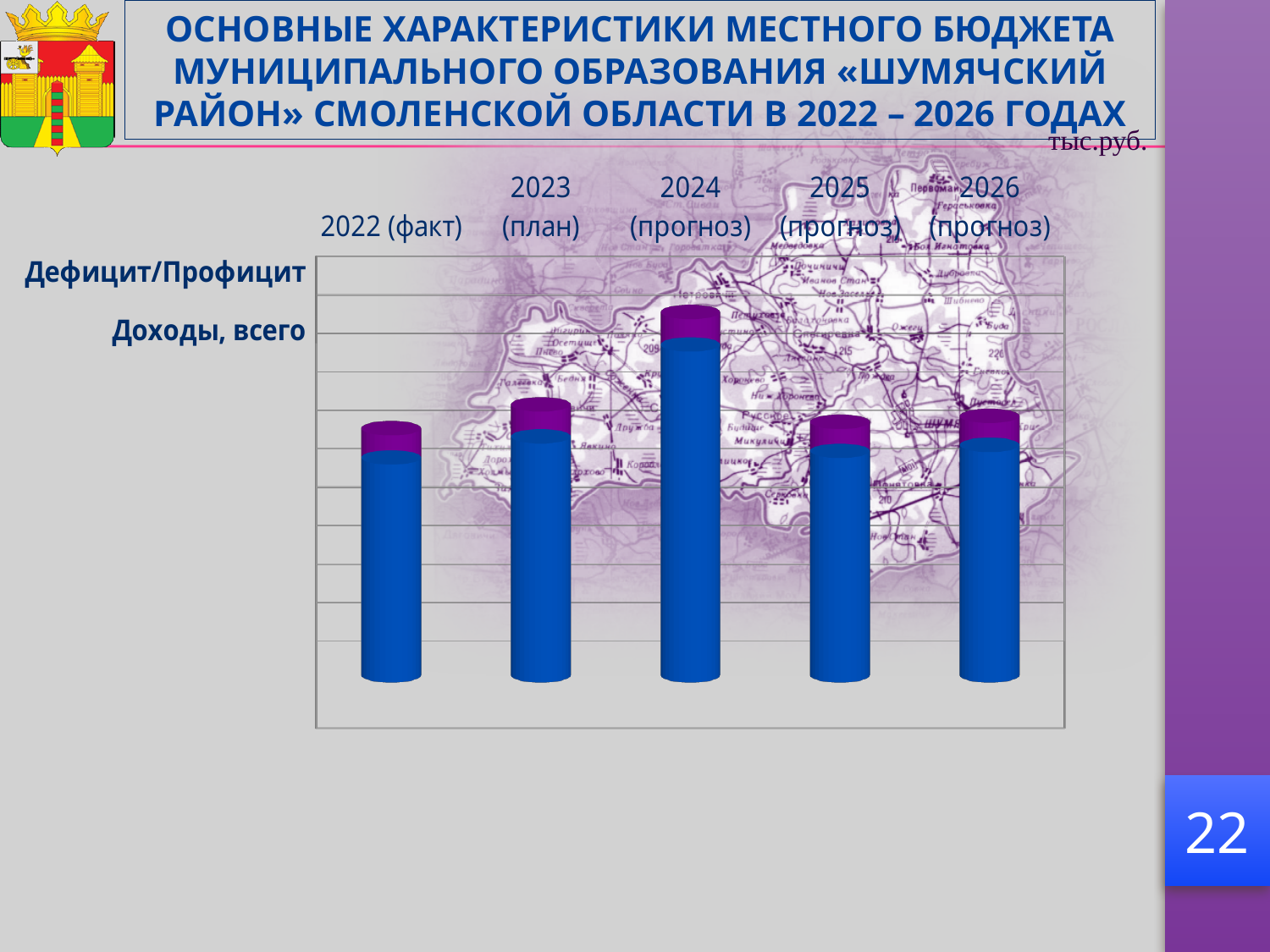
How many year categories are plotted on the chart? 5 What kind of chart is shown on the slide? bar chart Is the total bar for 2024 (прогноз) taller or shorter than the bar for 2022 (факт)? taller Is the total bar for 2025 (прогноз) taller or shorter than the bar for 2024 (прогноз)? shorter Is the total bar for 2023 (план) taller or shorter than the bar for 2022 (факт)? taller Do the bars rise or fall from 2024 (прогноз) to 2025 (прогноз)? fall What unit of measurement is indicated for the chart? тыс.руб. Which year has the tallest bar on the chart? 2024 (прогноз) Do the bars rise or fall from 2022 (факт) to 2024 (прогноз)? rise